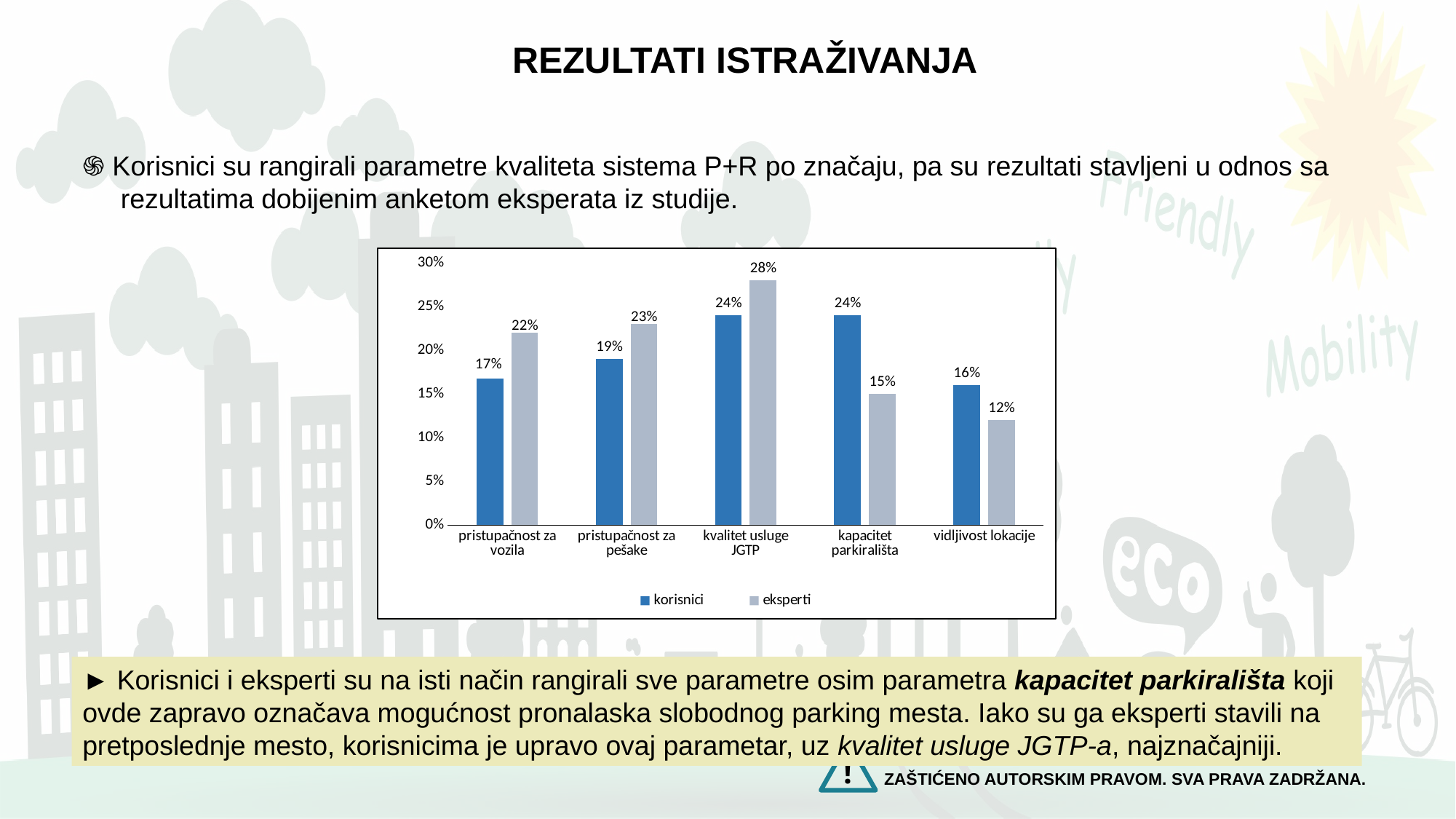
Which category has the highest value for eksperti? kvalitet usluge JGTP How many categories are shown on the x axis? 5 What is the value for eksperti for kvalitet usluge JGTP? 28% How many series does the legend list? 2 For pristupačnost za pešake, which is larger: the korisnici value or the eksperti value? eksperti Which category has the lowest value for korisnici? vidljivost lokacije What is the value for korisnici for pristupačnost za vozila? 17% What is the difference between the korisnici and eksperti values for kapacitet parkirališta? 9% What kind of chart is shown on the slide? bar chart What is the value for korisnici for vidljivost lokacije? 16% Which series is shown in blue? korisnici What is the value for eksperti for kapacitet parkirališta? 15%